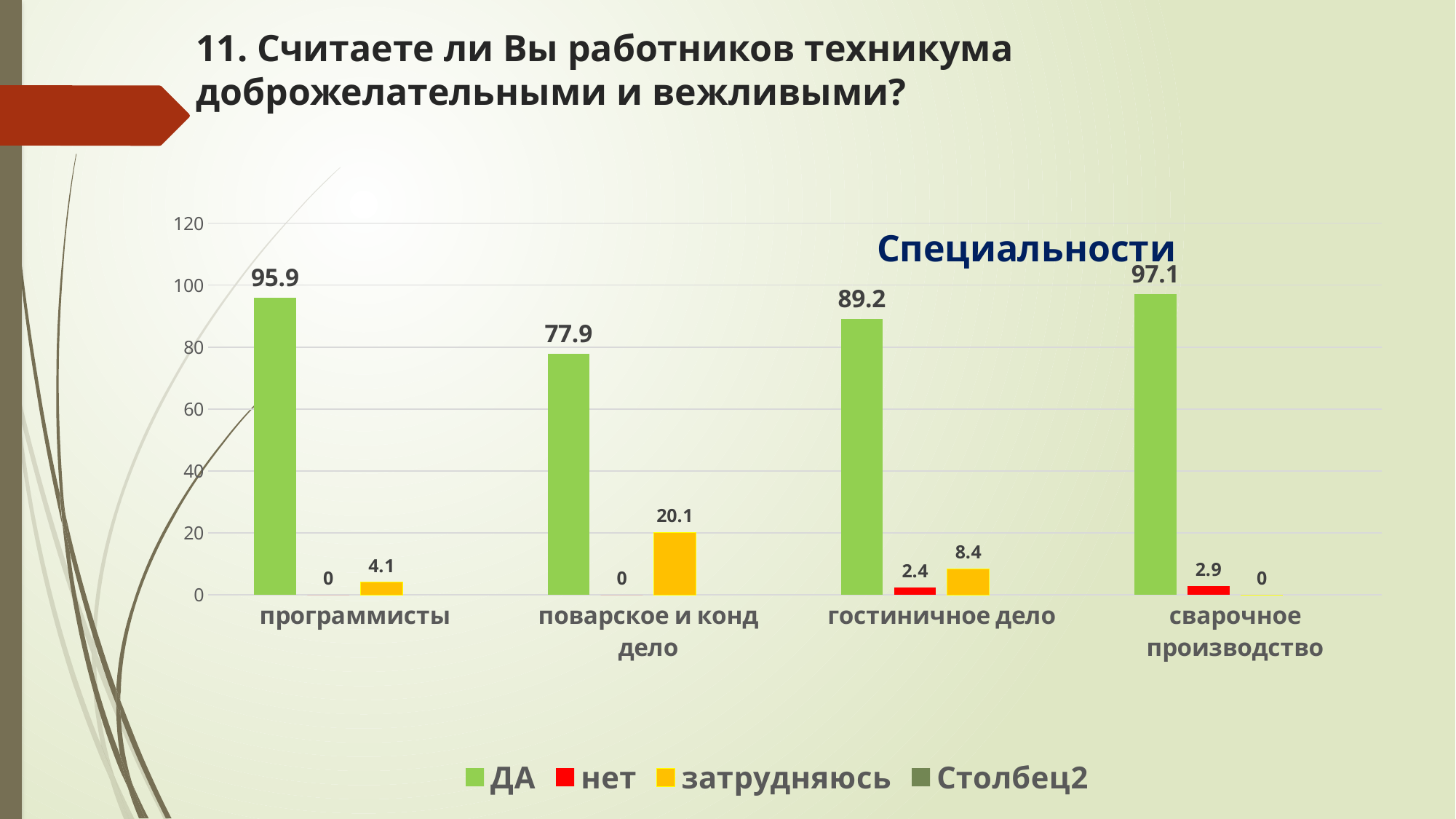
What kind of chart is shown on the slide? bar chart How many categories are shown on the x axis? 4 What is the value of the затрудняюсь series for поварское и конд дело? 20.1 What colour are the bars for the ДА series? green What is the difference between the ДА values for сварочное производство and поварское и конд дело? 19.2 Which category has the highest value in the ДА series? сварочное производство How many series does the legend list? 4 What is the value of the нет series for гостиничное дело? 2.4 Which is larger: the затрудняюсь value for программисты or for гостиничное дело? гостиничное дело What is the value of the ДА series for программисты? 95.9 What is the value of the нет series for сварочное производство? 2.9 Which category has the lowest value in the ДА series? поварское и конд дело